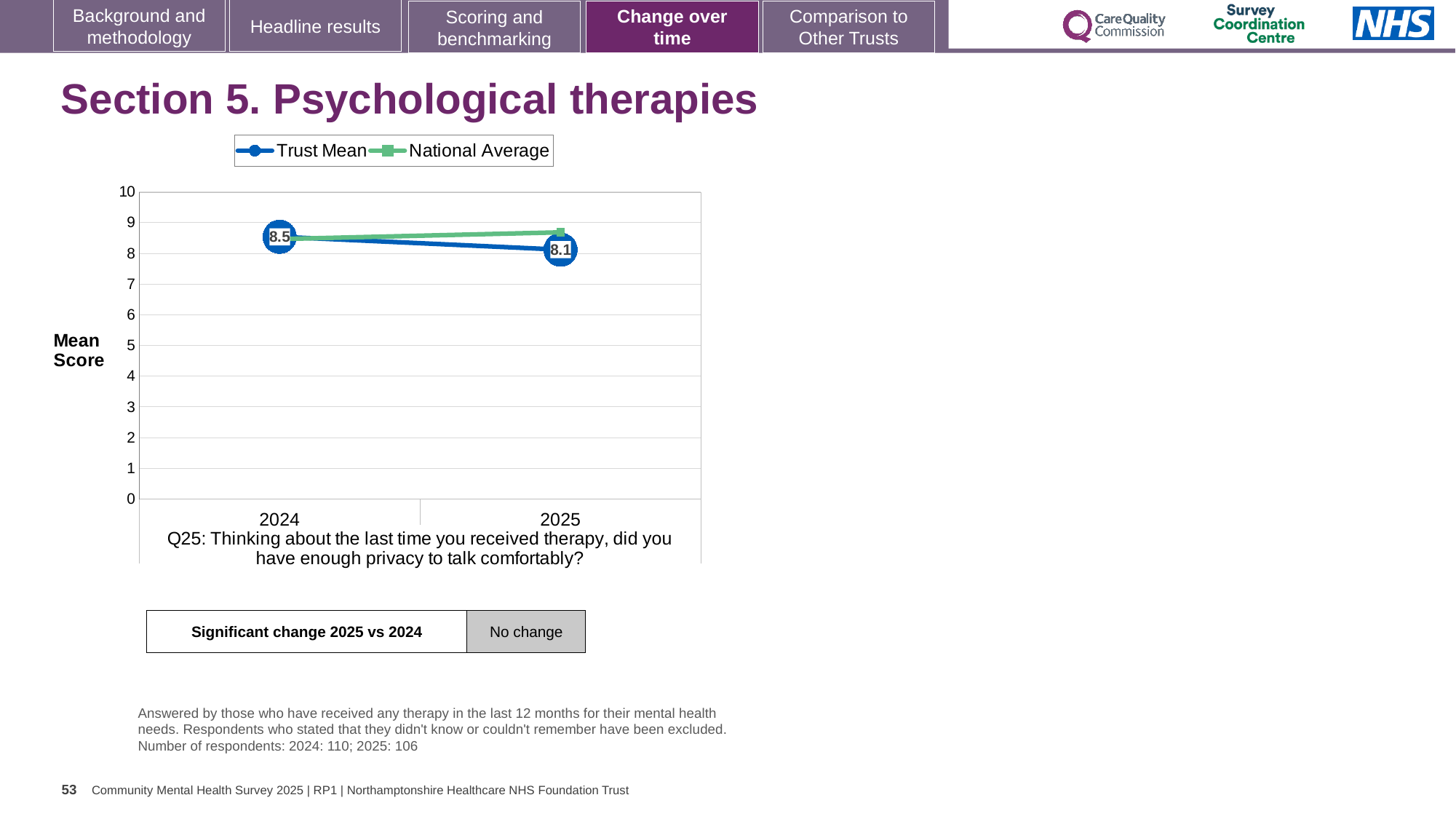
What is the Trust Mean score for 2025? 8.1 How many years are plotted on the x axis? 2 What is the label on the y axis of the chart? Mean Score In which year was the Trust Mean score higher? 2024 How many series does the legend list? 2 By how much did the Trust Mean score change from 2024 to 2025? decreased by 0.4 Is the National Average value for 2025 greater or less than 8? greater In 2025, which is higher: the Trust Mean or the National Average? National Average What is the Trust Mean score for 2024? 8.5 In which year was the Trust Mean score lowest? 2025 Does the Trust Mean rise or fall from 2024 to 2025? fall What kind of chart is shown on the slide? line chart